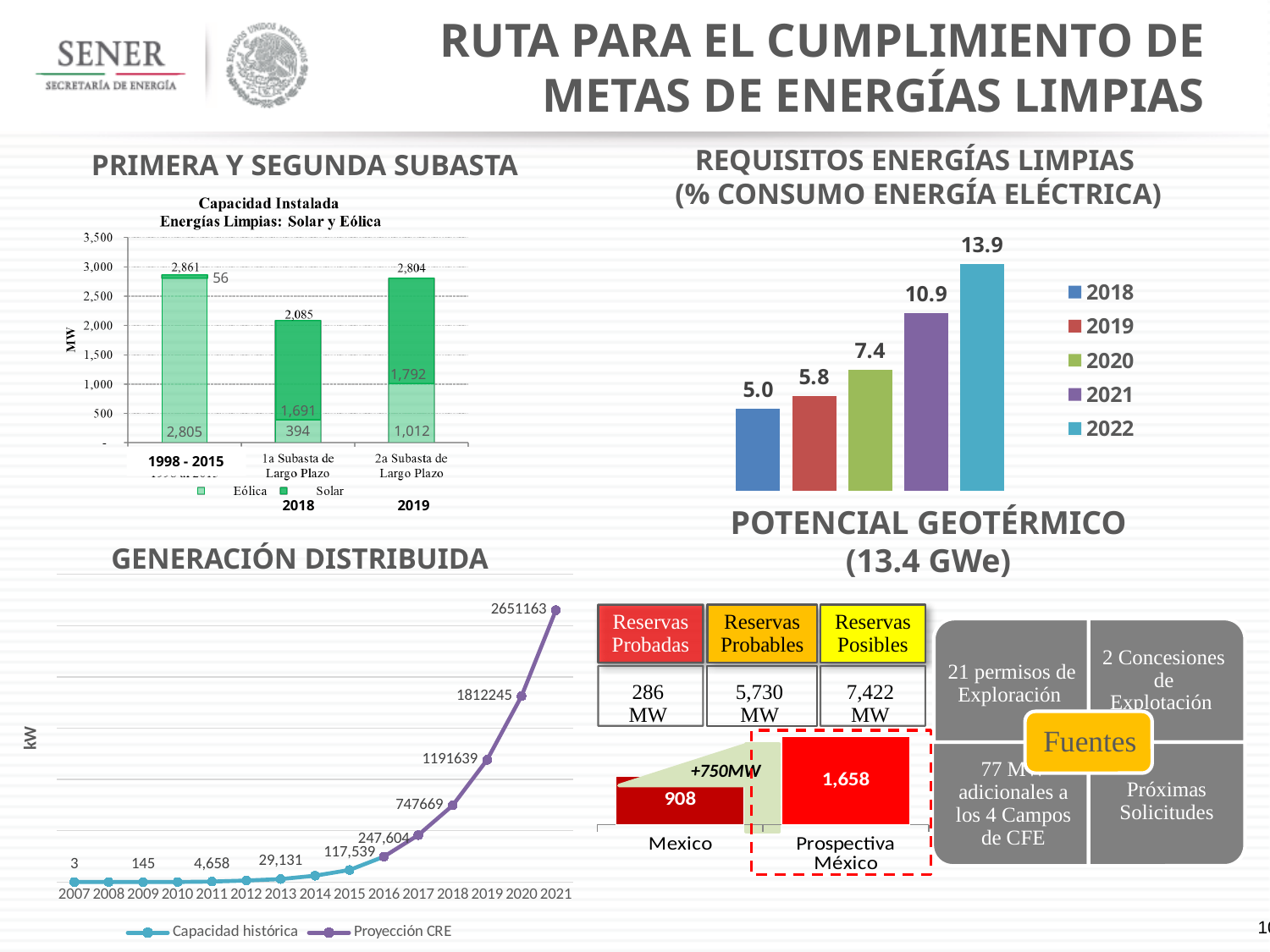
In the 'Requisitos Energías Limpias' chart, do the values rise or fall from 2018 to 2022? rise In the 'Capacidad Instalada Energías Limpias: Solar y Eólica' chart, which category has the lowest total installed capacity? 1a Subasta de Largo Plazo In the 'Capacidad Instalada Energías Limpias: Solar y Eólica' chart, what is the total of the stacked bar for the 2a Subasta de Largo Plazo? 2,804 In the 'Capacidad Instalada Energías Limpias: Solar y Eólica' chart, what is the Eólica value for 1998 - 2015? 2,805 In the 'Capacidad Instalada Energías Limpias: Solar y Eólica' chart, how many series does the legend list? 2 In the 'Requisitos Energías Limpias' chart, which year has the highest value? 2022 In the 'Requisitos Energías Limpias' chart, what is the difference between the 2022 and 2021 values? 3.0 In the 'Capacidad Instalada Energías Limpias: Solar y Eólica' chart, what is the Solar value for the 1a Subasta de Largo Plazo? 1,691 In the 'Potencial Geotérmico' chart, what is the value for Prospectiva México? 1,658 What kind of chart is the 'Generación Distribuida' chart? line chart In the 'Generación Distribuida' chart, what is the value of the last point, for 2021? 2651163 In the 'Requisitos Energías Limpias' chart, what is the value for 2020? 7.4